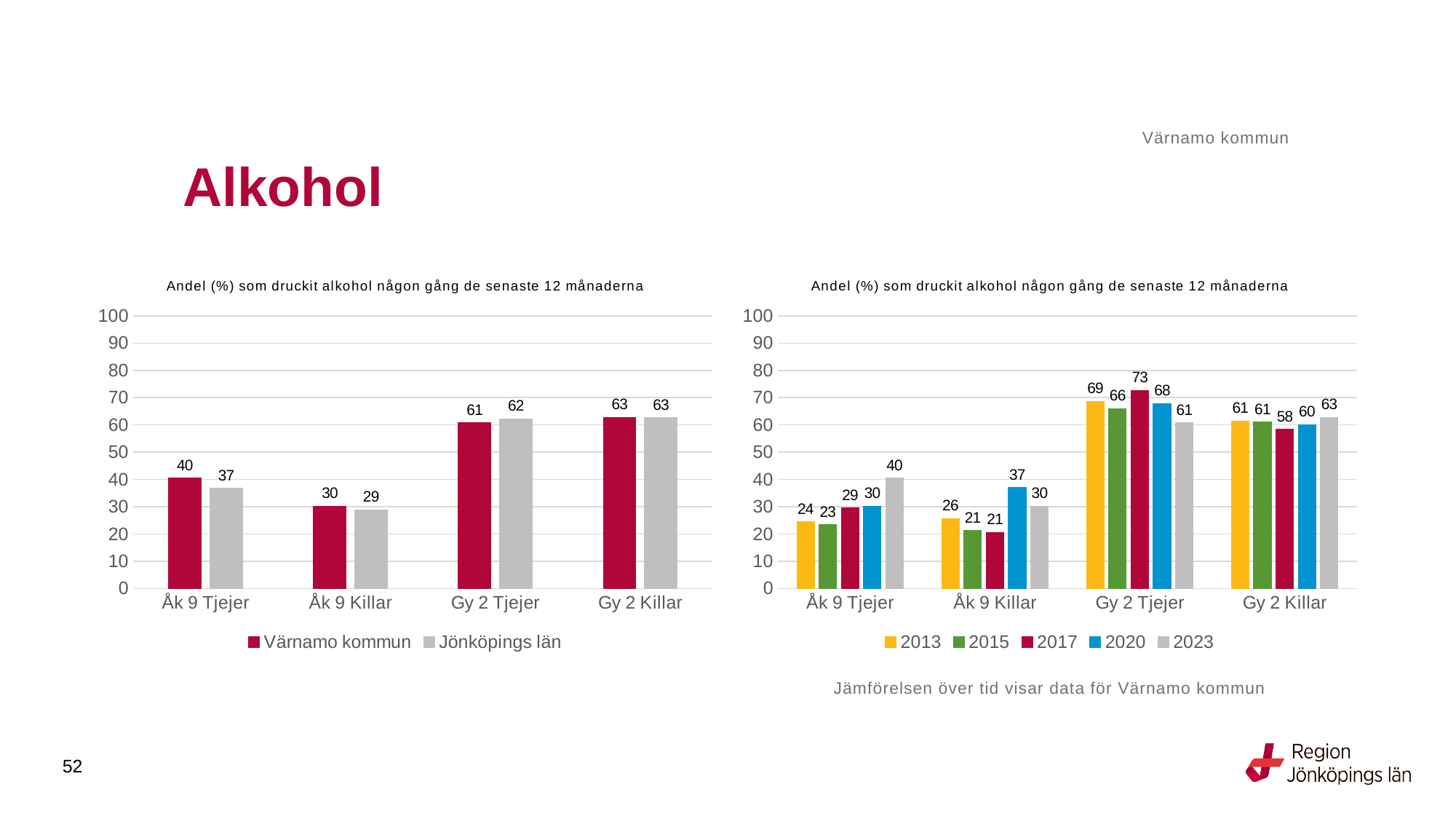
In the left chart, what is the value for Jönköpings län for Gy 2 Tjejer? 62 In the left chart, which category has the lowest value for Jönköpings län? Åk 9 Killar In the right chart, which is larger for Åk 9 Killar: the value for 2020 or the value for 2023? 2020 In the right chart, what is the value for 2017 for Gy 2 Tjejer? 73 In the right chart, what is the value for 2023 for Åk 9 Killar? 30 What kind of chart is the right chart? Bar chart In the left chart, what is the difference between Värnamo kommun and Jönköpings län for Åk 9 Tjejer? 3 In the right chart, what is the difference between the 2013 and 2023 values for Gy 2 Tjejer? 8 How many series does the legend of the left chart list? 2 In the left chart, what is the value for Värnamo kommun for Åk 9 Tjejer? 40 In the right chart, which year has the highest value for Åk 9 Tjejer? 2023 How many series does the legend of the right chart list? 5